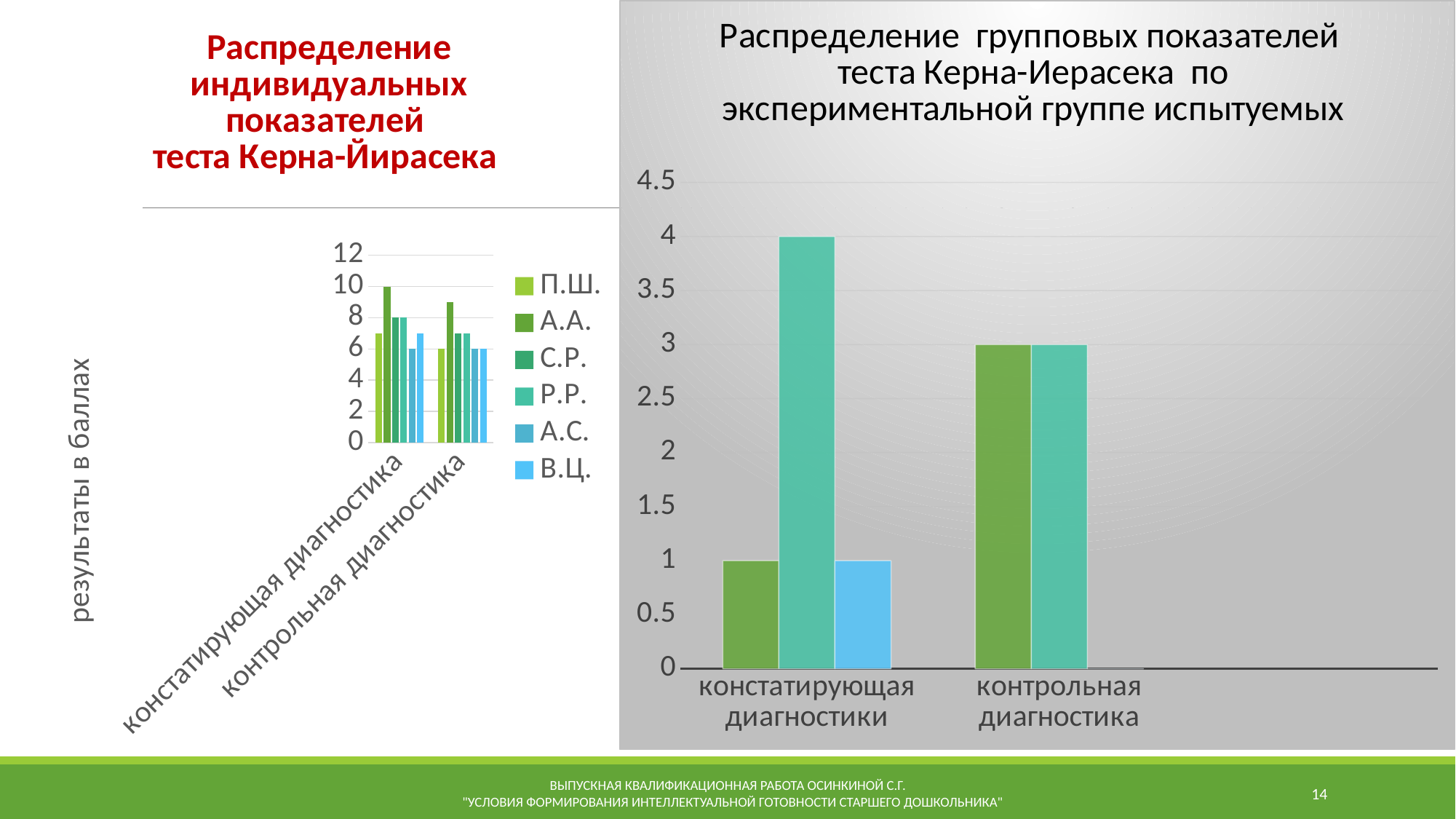
In the right chart, what is the difference between the tallest bar in 'констатирующая диагностики' and the green bar in 'контрольная диагностика'? 1 What kind of chart is the chart on the right, titled 'Распределение групповых показателей теста Керна-Иерасека по экспериментальной группе испытуемых'? bar chart In the right chart, how many categories are shown on the x axis? 2 In the left chart, is the value for А.А. in 'контрольная диагностика' greater or less than 8? greater In the left chart, which series has the highest value in the 'констатирующая диагностика' category? А.А. In the right chart, what is the value of the tallest bar in the 'констатирующая диагностики' category? 4 In the right chart, which is larger: the green bar in 'констатирующая диагностики' or the green bar in 'контрольная диагностика'? контрольная диагностика In the right chart, what is the value of the green bar in the 'контрольная диагностика' category? 3 In the right chart, what is the value of the blue bar in the 'констатирующая диагностики' category? 1 In the right chart, how many bars are shown in the 'контрольная диагностика' category? 2 In the right chart, what is the value of the first (green) bar in the 'констатирующая диагностики' category? 1 In the left chart, titled 'Распределение индивидуальных показателей теста Керна-Йирасека', how many series does the legend list? 6